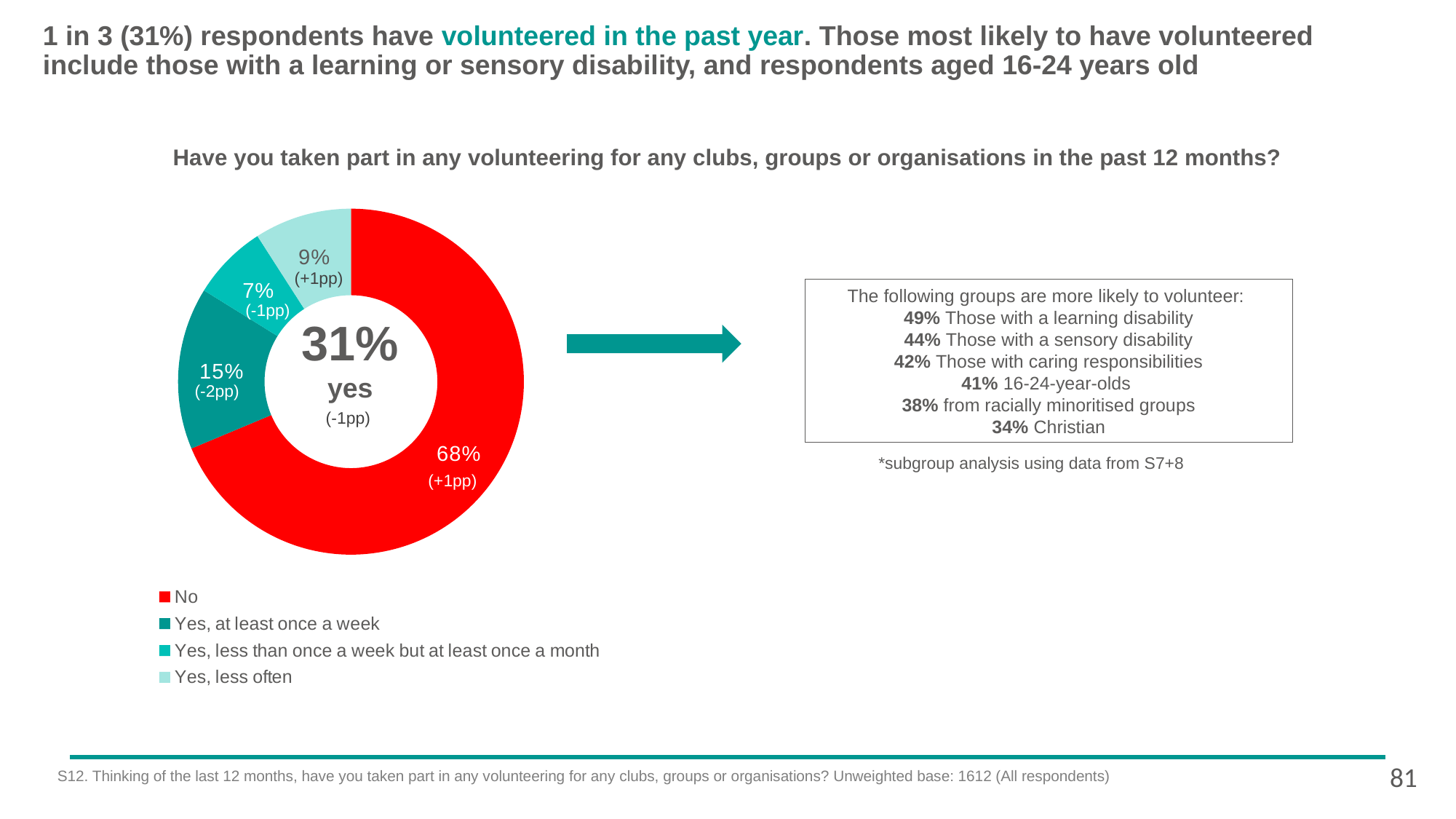
Which is larger: the share for "Yes, less often" or the share for "Yes, less than once a week but at least once a month"? Yes, less often Which response category has the smallest share of the donut chart? Yes, less than once a week but at least once a month Which response category has the largest share of the donut chart? No What total percentage of respondents said "yes" to volunteering, as shown in the centre of the donut? 31% What percentage of respondents said "Yes, at least once a week"? 15% What percentage of respondents said "Yes, less than once a week but at least once a month"? 7% How many response categories does the legend list? 4 What kind of chart is shown on the slide? Pie (donut) chart What percentage of respondents said "Yes, less often"? 9% What percentage of respondents answered "No" to the volunteering question? 68% What is the difference in percentage points between "No" and "Yes, at least once a week"? 53 What change in percentage points is shown next to the "No" slice? +1pp